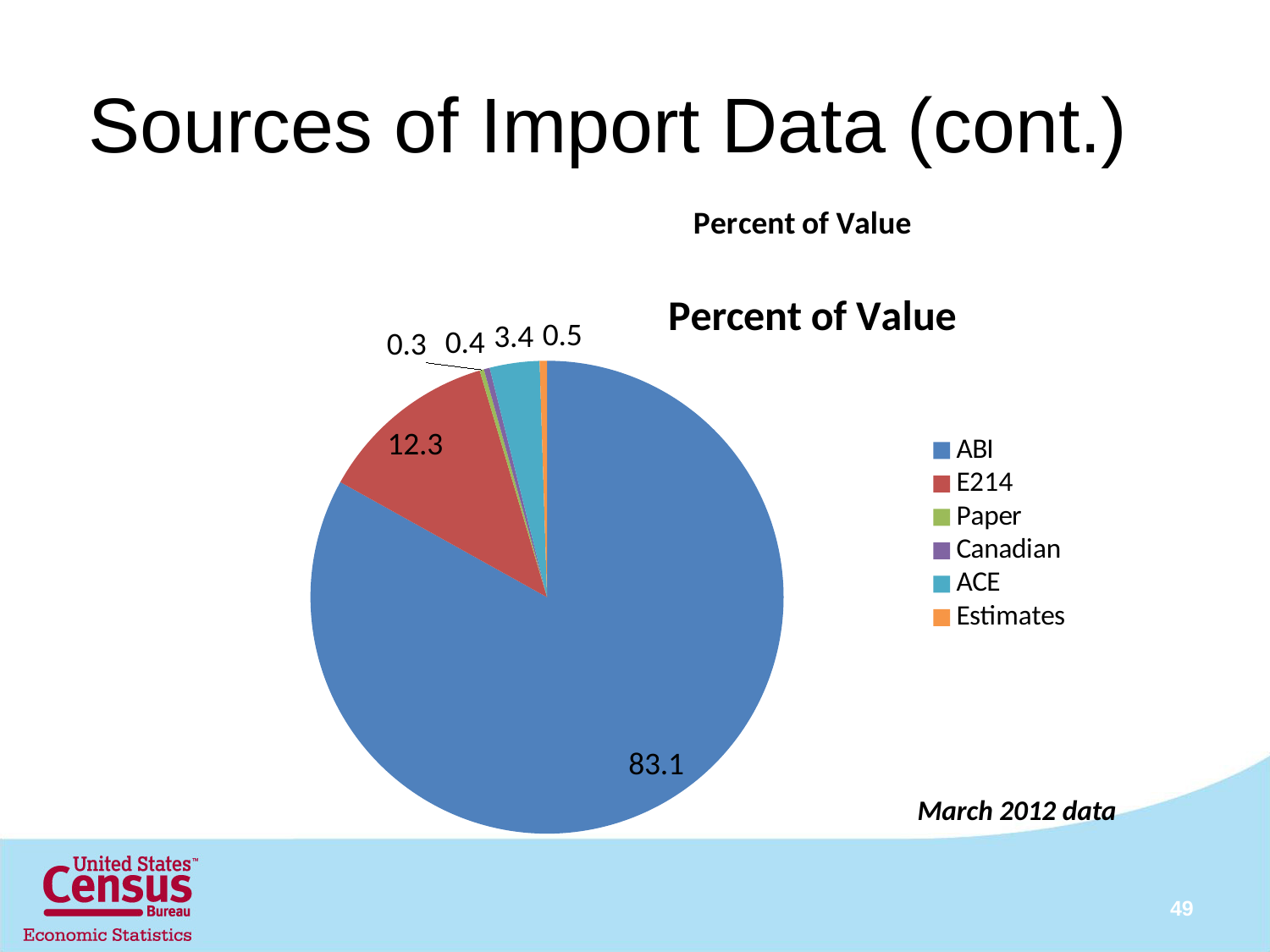
What is the value for E214? 12.3 What is the difference between the values for ABI and E214? 70.8 What is the value for Estimates? 0.5 What is the value for ACE? 3.4 What is the chart's title? Percent of Value What is the value for Paper? 0.3 How many slices does the pie chart have? 6 Which category has the largest share of the pie? ABI What is the value for ABI? 83.1 What type of chart is shown on the slide? pie chart Which is larger, the value for ACE or the value for Canadian? ACE Which category has the smallest share of the pie? Paper